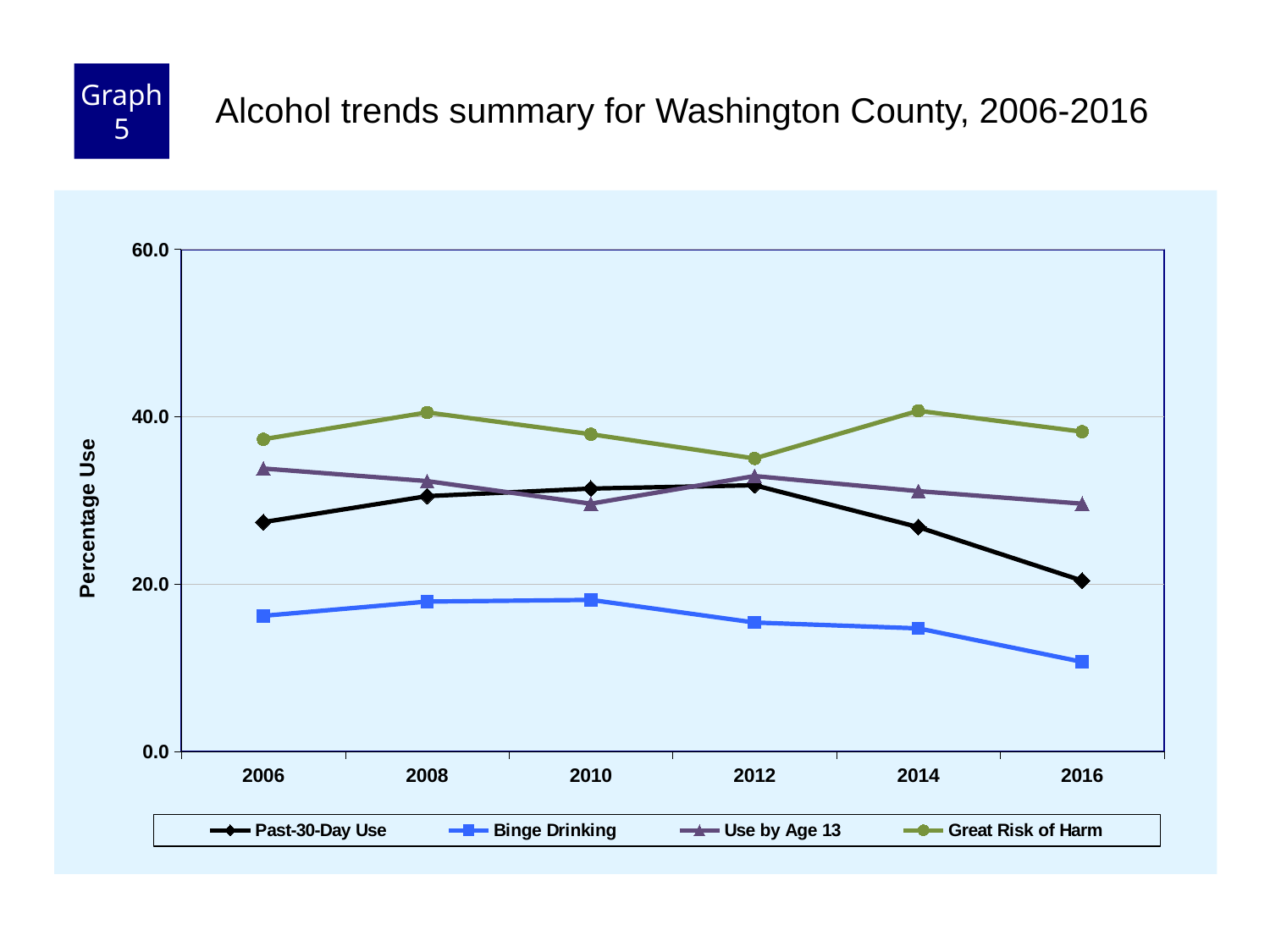
Does Past-30-Day Use rise or fall from 2012 to 2016? Fall How many years are plotted along the x axis? 6 Which series has the highest value in 2006? Great Risk of Harm Is the value for Binge Drinking in 2016 greater or less than 20.0? less In which year is Binge Drinking at its lowest? 2016 How many series does the legend list? 4 In which year is Great Risk of Harm at its lowest? 2012 What kind of chart is shown on the slide? Line chart Which series has the lowest values across all years? Binge Drinking Is the value for Great Risk of Harm in 2012 greater or less than 40.0? less Is the value for Past-30-Day Use in 2006 greater or less than 20.0? greater In 2016, which is larger: Past-30-Day Use or Use by Age 13? Use by Age 13